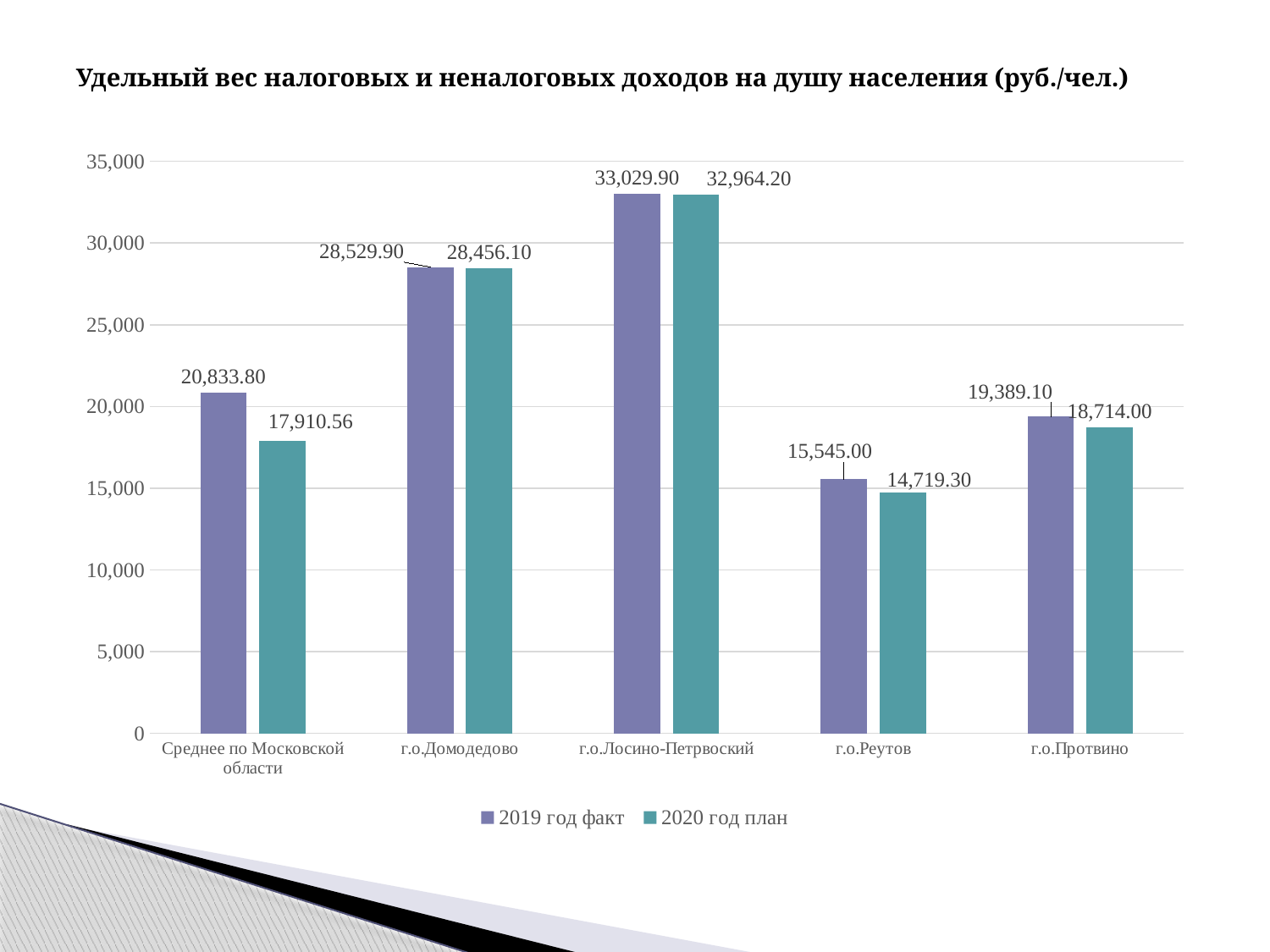
What is the value for г.о.Домодедово in the 2019 год факт series? 28,529.90 What kind of chart is shown on the slide? bar chart Is the 2019 год факт value for г.о.Лосино-Петрвоский greater or less than 30,000? greater Which category has the highest 2019 год факт value? г.о.Лосино-Петрвоский What is the difference between the 2019 год факт and 2020 год план values for г.о.Реутов? 825.70 What is the 2020 год план value for Среднее по Московской области? 17,910.56 Which category has the lowest 2020 год план value? г.о.Реутов What is the difference between the 2019 год факт and 2020 год план values for Среднее по Московской области? 2,923.24 Which is larger for г.о.Протвино: the 2019 год факт value or the 2020 год план value? 2019 год факт How many series does the legend list? 2 What is the 2020 год план value for г.о.Реутов? 14,719.30 How many categories are shown on the x axis? 5